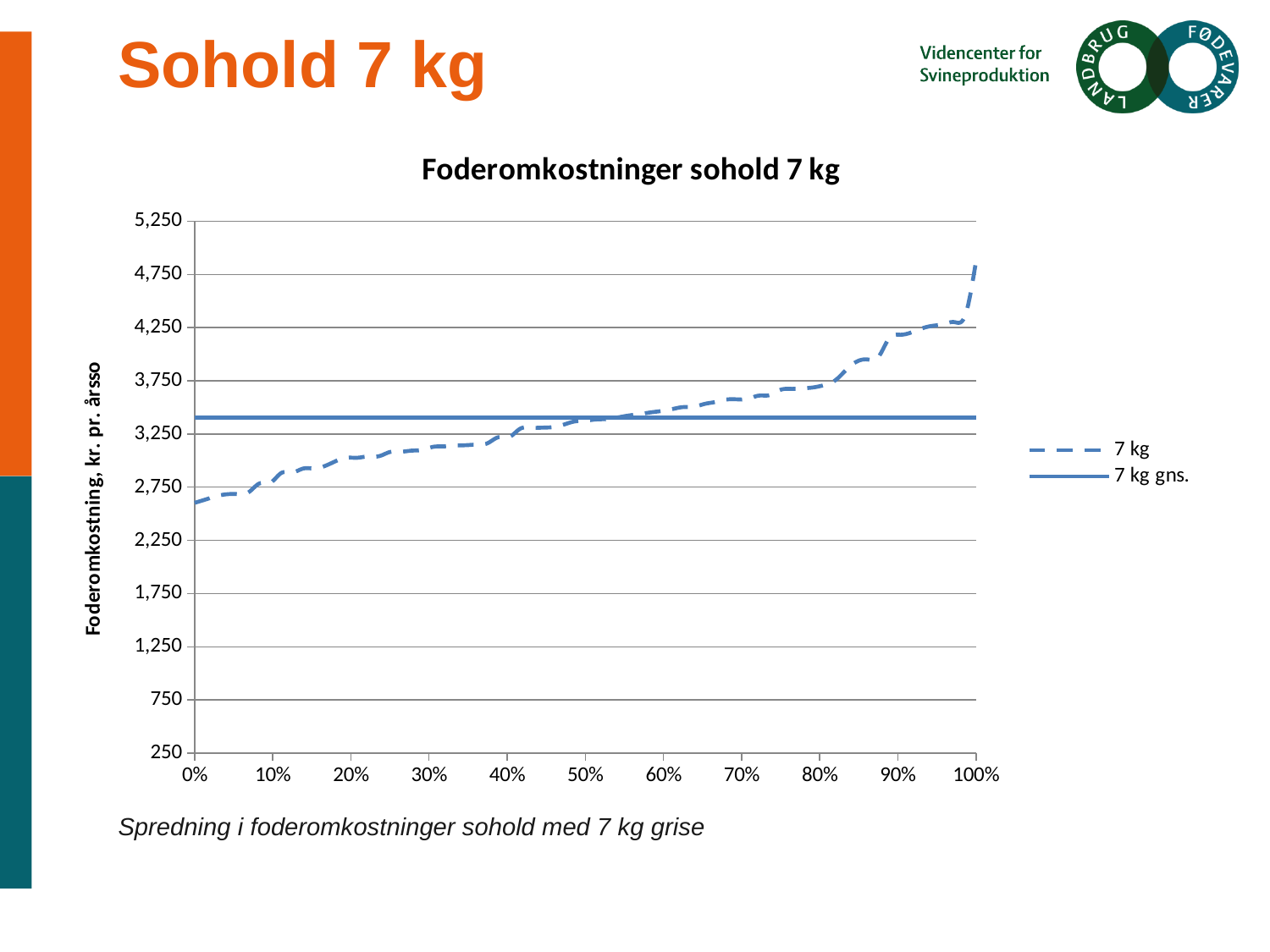
At 0%, which series has the larger value, 7 kg or 7 kg gns.? 7 kg gns. Is the value of the 7 kg series at 20% greater or less than 3,250? less Is the value of the 7 kg series at 100% greater or less than 4,250? greater What kind of chart is shown on the slide? line chart What is the label on the vertical axis of the chart? Foderomkostning, kr. pr. årsso At 100%, which series has the larger value, 7 kg or 7 kg gns.? 7 kg Does the 7 kg series rise or fall as the x axis goes from 0% to 100%? rise Is the value of the 7 kg gns. series greater or less than 3,250? greater What is the title of the chart? Foderomkostninger sohold 7 kg How many series does the legend list? 2